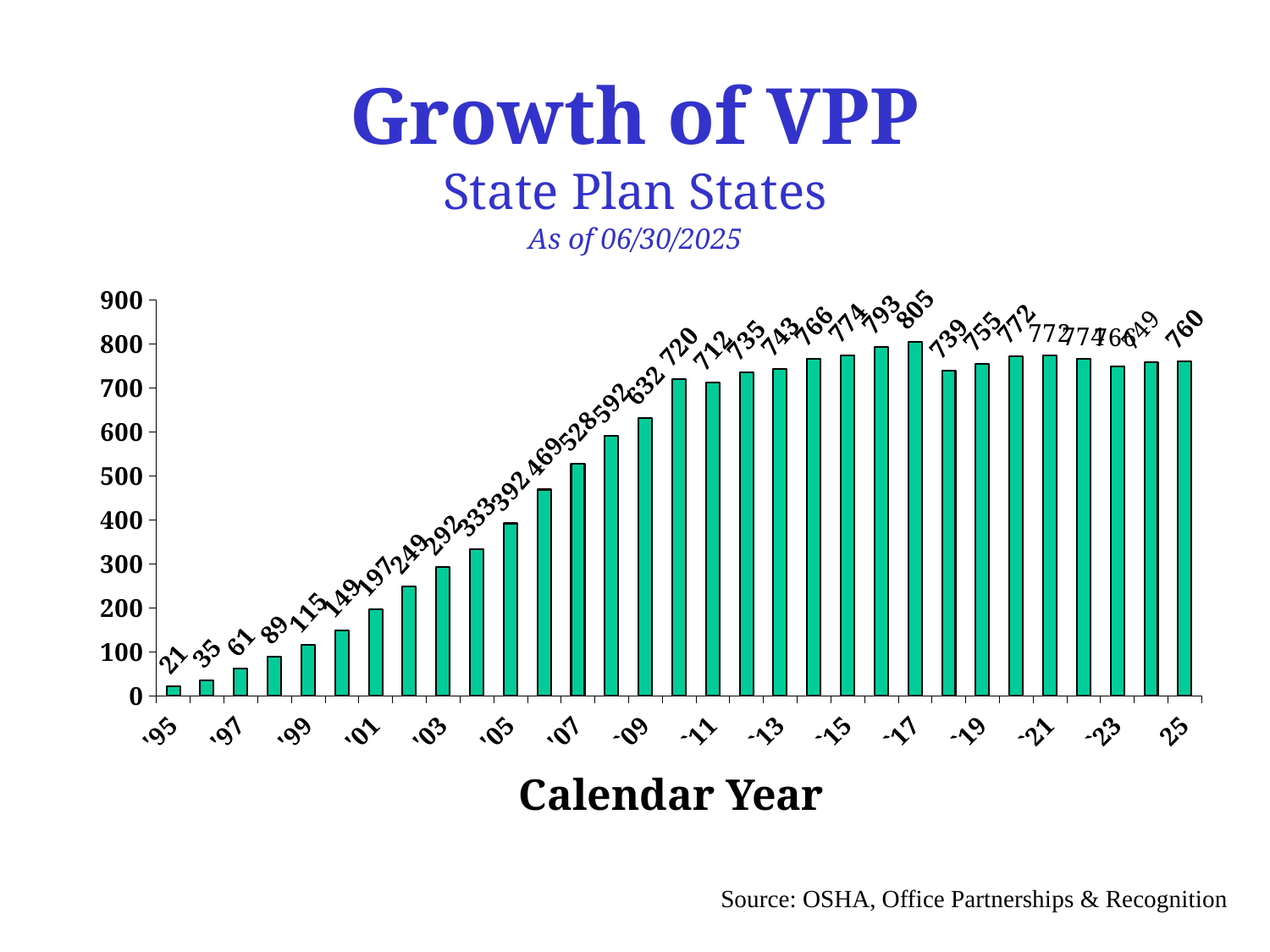
Which calendar year has the highest value? '17 Do the values rise or fall from '95 to '17? rise Is the value for '09 greater or less than 600? greater What is the value for '95? 21 What is the value for '05? 392 Which calendar year has the lowest value? '95 What kind of chart is shown on the slide? bar chart What is the main title of the chart? Growth of VPP What is the value for '17? 805 What is the value for '25? 760 What is the difference between the values for '17 and '18? 66 Which is larger, the value for '10 or the value for '11? '10